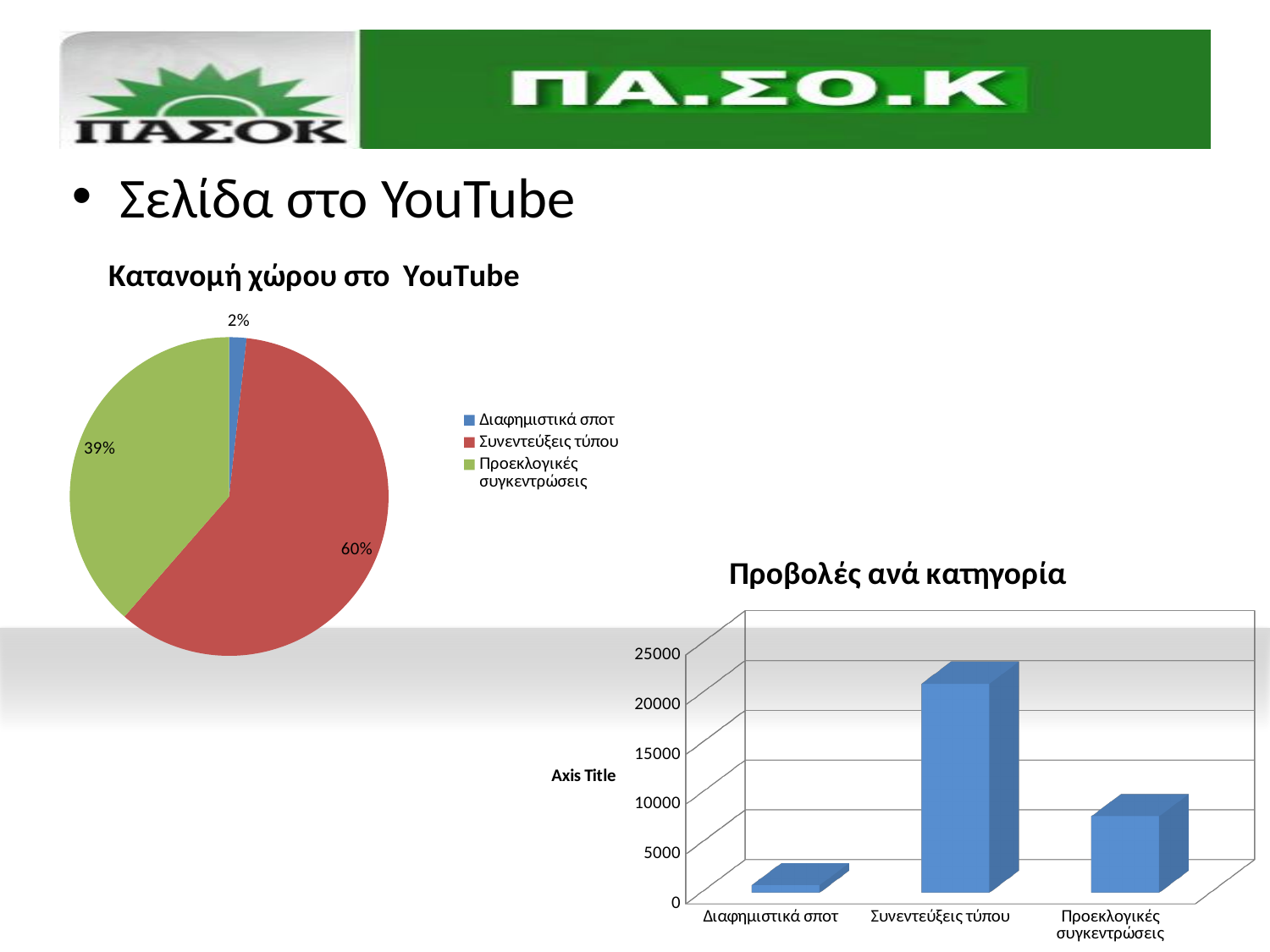
In the pie chart 'Κατανομή χώρου στο YouTube', which category has the largest share? Συνεντεύξεις τύπου In the pie chart 'Κατανομή χώρου στο YouTube', which category has the smallest share? Διαφημιστικά σποτ In the pie chart 'Κατανομή χώρου στο YouTube', what share does 'Προεκλογικές συγκεντρώσεις' have? 39% How many categories does the legend of the pie chart 'Κατανομή χώρου στο YouTube' list? 3 In the pie chart 'Κατανομή χώρου στο YouTube', what share does 'Διαφημιστικά σποτ' have? 2% In the bar chart 'Προβολές ανά κατηγορία', which category has the highest value? Συνεντεύξεις τύπου In the bar chart 'Προβολές ανά κατηγορία', which category has the lowest value? Διαφημιστικά σποτ In the pie chart 'Κατανομή χώρου στο YouTube', what share does 'Συνεντεύξεις τύπου' have? 60% In the bar chart 'Προβολές ανά κατηγορία', is the value for 'Συνεντεύξεις τύπου' greater or less than 15000? greater In the bar chart 'Προβολές ανά κατηγορία', is the value for 'Προεκλογικές συγκεντρώσεις' greater or less than 10000? less What kind of chart is 'Προβολές ανά κατηγορία'? bar chart In the pie chart 'Κατανομή χώρου στο YouTube', what is the difference in percentage points between 'Συνεντεύξεις τύπου' and 'Προεκλογικές συγκεντρώσεις'? 21